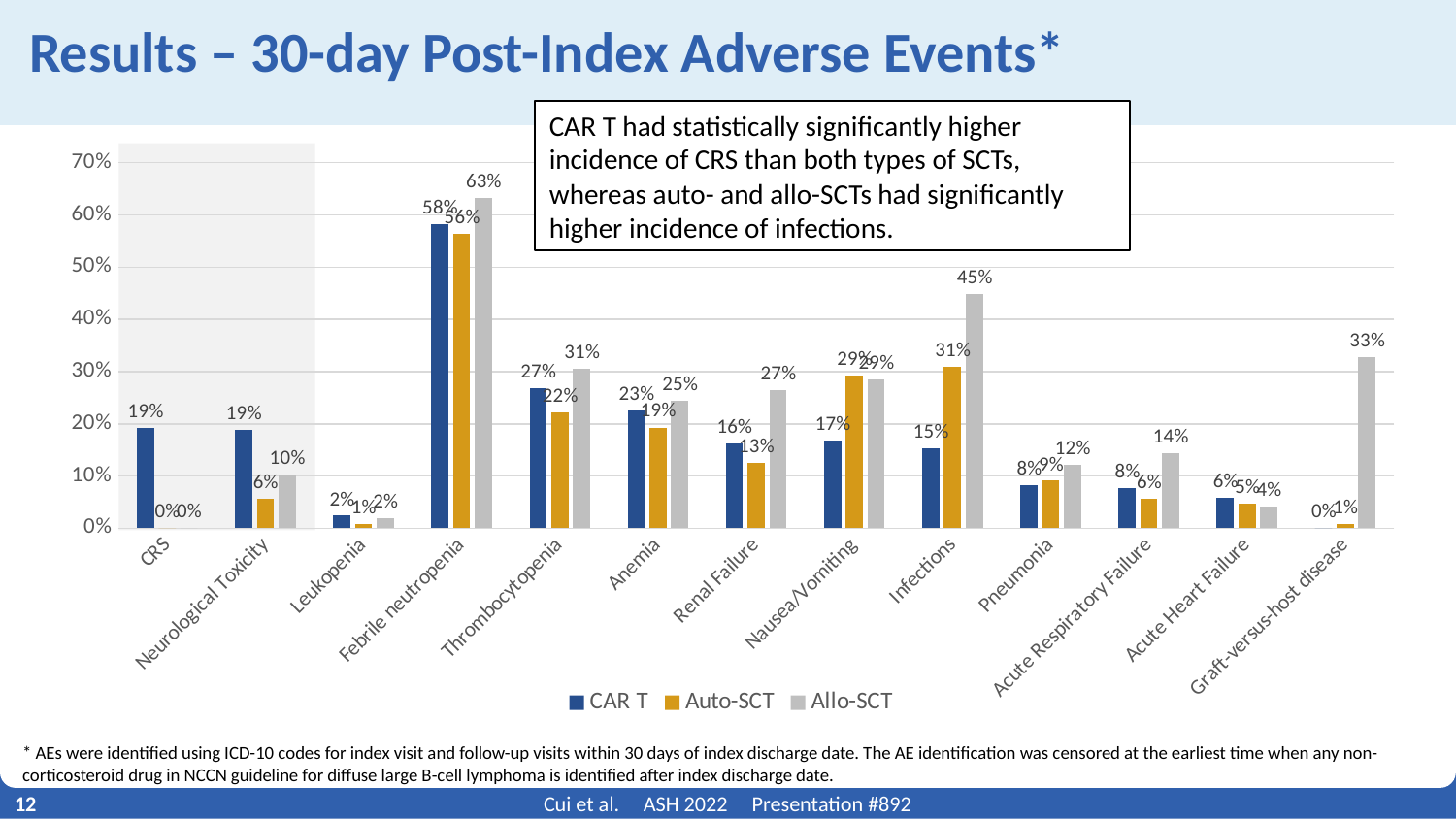
What kind of chart is shown on the slide? Bar chart For Renal Failure, which series has the larger value, CAR T or Allo-SCT? Allo-SCT Which category has the highest Allo-SCT value? Febrile neutropenia Which category has the highest CAR T value? Febrile neutropenia What is the Allo-SCT value for Infections? 45% What is the CAR T value for CRS? 19% What is the difference between the Allo-SCT and CAR T values for Infections? 30% How many adverse event categories are shown on the x axis? 13 How many series does the legend list? 3 What is the Auto-SCT value for Thrombocytopenia? 22% Which series is shown in grey in the legend? Allo-SCT What is the Allo-SCT value for Graft-versus-host disease? 33%